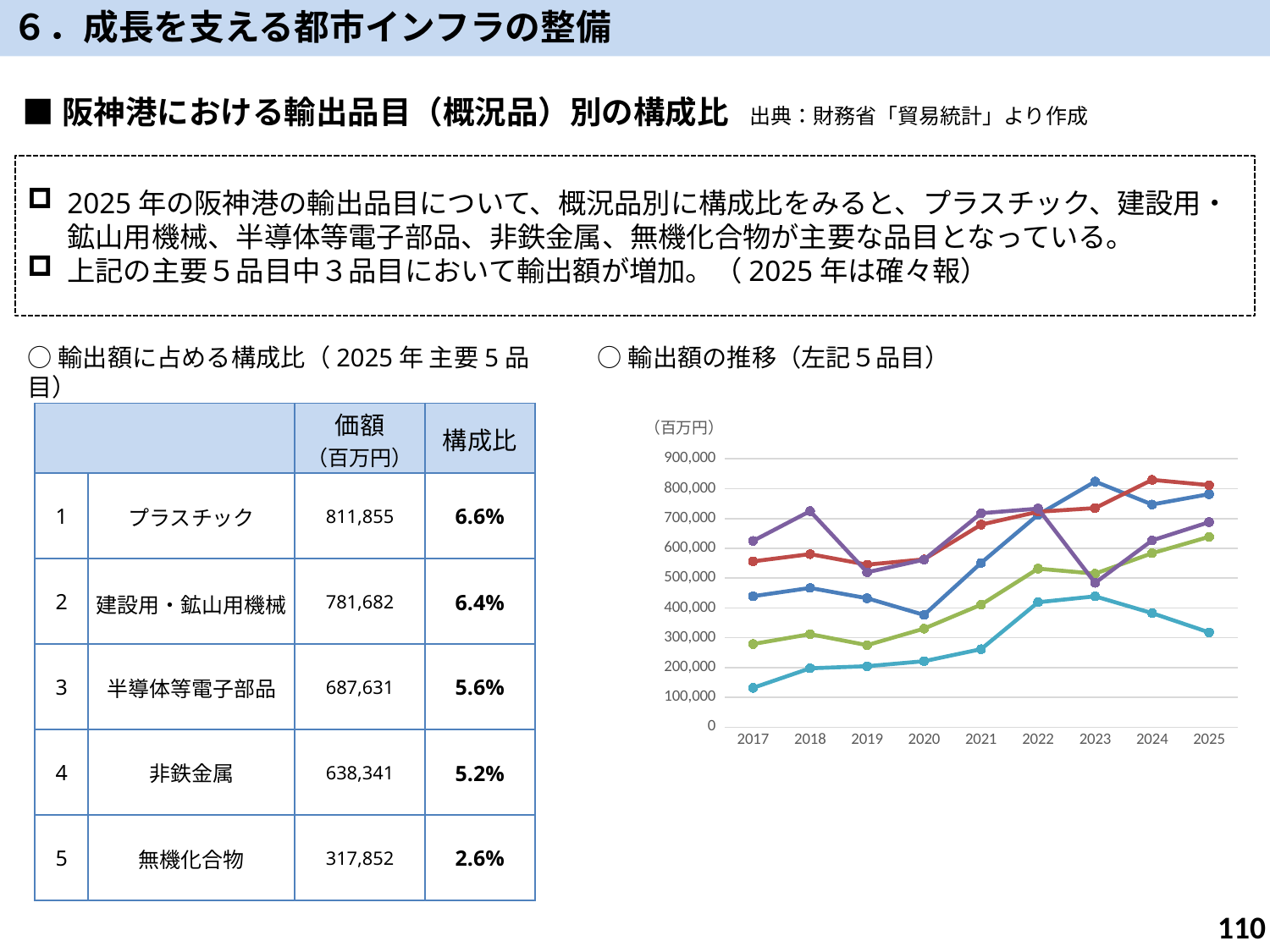
In the 「輸出額の推移」 chart, is the value of the green line in 2025 greater or less than 600,000? greater In the 「輸出額の推移」 chart, is the value of the red line in 2025 greater or less than 700,000? greater How many lines are plotted in the 「輸出額の推移」 chart? 5 In the 「輸出額の推移」 chart, does the light blue (cyan) line rise or fall from 2023 to 2025? fall What unit is shown at the top left of the 「輸出額の推移」 chart's y axis? 百万円 In the 「輸出額の推移」 chart, is the value of the dark blue line in 2020 greater or less than 500,000? less In the 「輸出額の推移」 chart, in which year does the dark blue line reach its highest value? 2023 How many years are shown on the x axis of the 「輸出額の推移」 chart? 9 What kind of chart is shown under 「輸出額の推移（左記５品目）」? line chart In the 「輸出額の推移」 chart, in 2018, which is higher: the purple line or the red line? purple line In the 「輸出額の推移」 chart, does the green line rise or fall overall from 2017 to 2025? rise